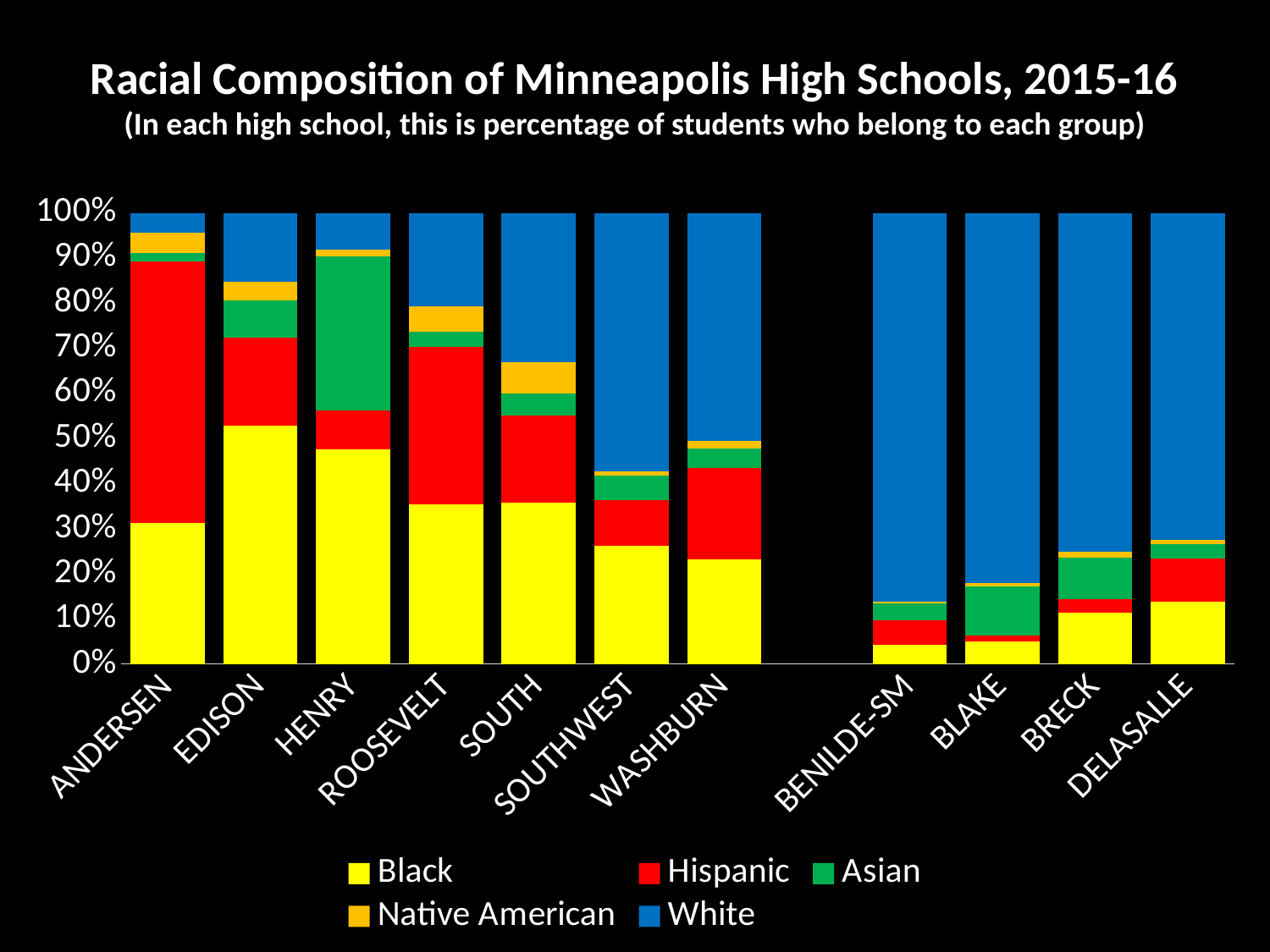
Which high school has the largest Hispanic share of students? Andersen Is the Black share of students at Benilde-SM greater or less than 10%? less What kind of chart is shown on the slide? Stacked bar chart How many racial groups does the legend list? 5 Which high school has the largest Asian share of students? Henry Which school has a larger White share of students, Southwest or Washburn? Southwest Is the Black share of students at Southwest greater or less than 30%? less Is the Black share of students at Henry greater or less than 50%? less Which high school has the smallest White share of students? Andersen Which colour represents Native American students in the chart? Orange Which high school has the largest Black share of students? Edison How many high schools are shown on the x axis of the chart? 11